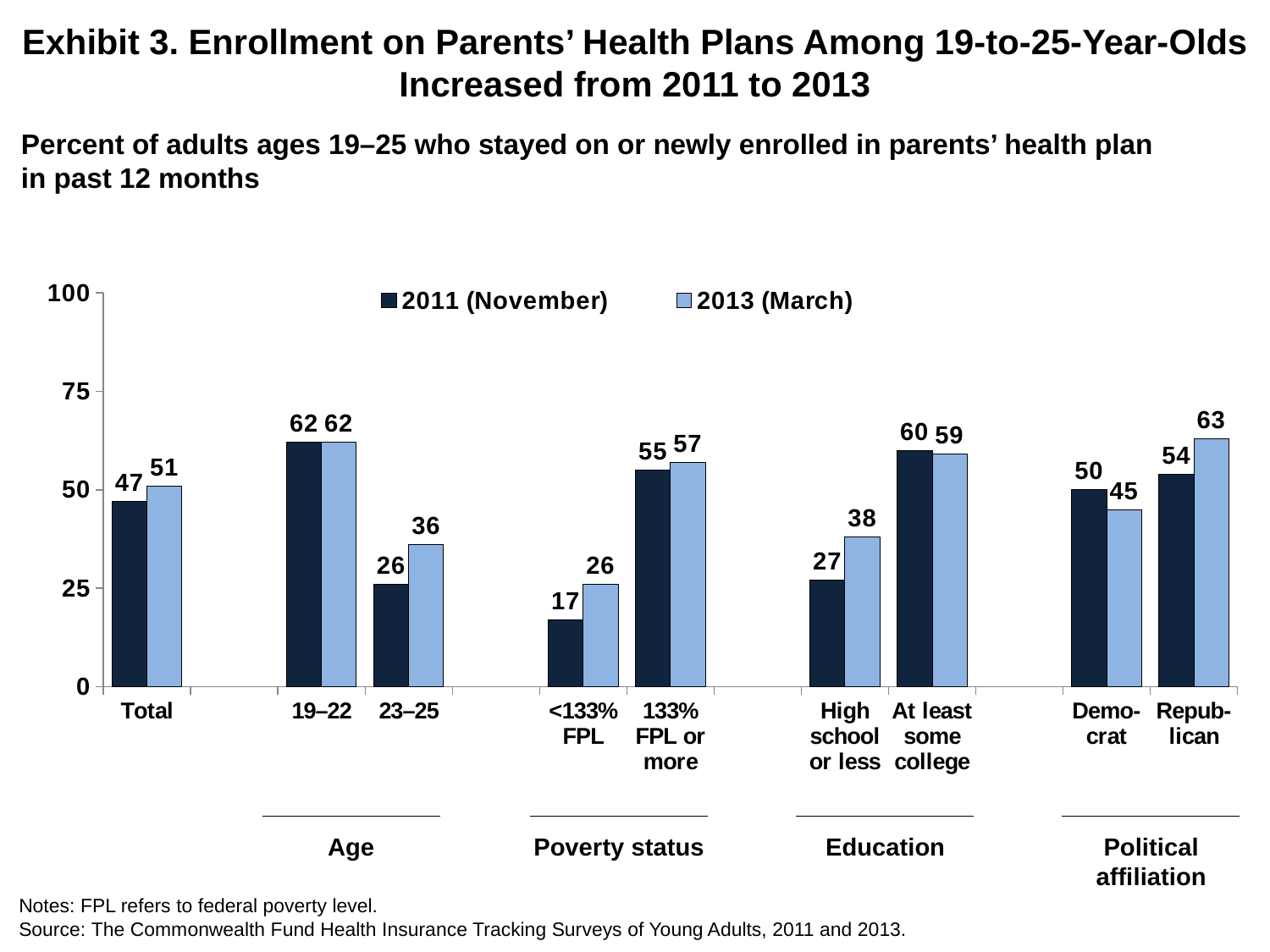
Which category has the highest 2013 (March) value? Republican What kind of chart is shown on the slide? Bar chart Which is larger for Democrat: the 2011 (November) value or the 2013 (March) value? 2011 (November) Which series is shown in light blue in the legend? 2013 (March) Which category has the lowest 2011 (November) value? <133% FPL What is the difference between the 2013 (March) values for High school or less and At least some college? 21 What is the 2013 (March) value for Republican? 63 What is the 2013 (March) value for Total? 51 What is the 2011 (November) value for the <133% FPL group? 17 How many series does the legend list? 2 What is the difference between the 2013 (March) and 2011 (November) values for the 23–25 age group? 10 How many categories are shown on the x axis? 9